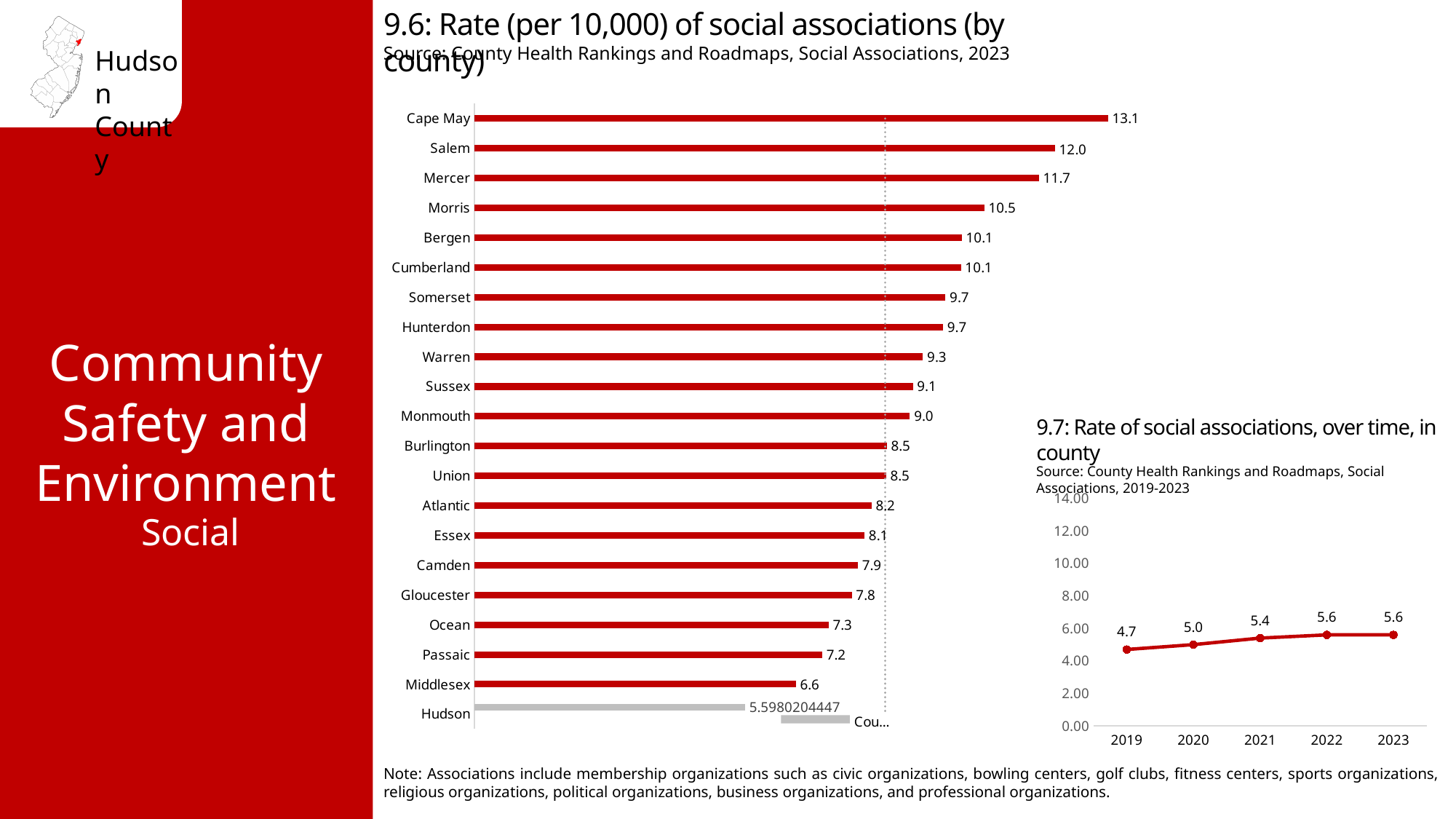
In the chart '9.7: Rate of social associations, over time, in county', what is the value for 2021? 5.4 In the chart '9.6: Rate (per 10,000) of social associations (by county)', which county has the highest rate? Cape May In the chart '9.7: Rate of social associations, over time, in county', do the values rise or fall from 2019 to 2023? Rise In the chart '9.7: Rate of social associations, over time, in county', what is the value for 2019? 4.7 In the chart '9.6: Rate (per 10,000) of social associations (by county)', how many counties are shown? 21 In the chart '9.6: Rate (per 10,000) of social associations (by county)', which has a higher rate, Ocean or Passaic? Ocean In the chart '9.6: Rate (per 10,000) of social associations (by county)', which county has the lowest rate? Hudson In the chart '9.6: Rate (per 10,000) of social associations (by county)', what is the value for Middlesex? 6.6 In the chart '9.6: Rate (per 10,000) of social associations (by county)', what is the difference between the values for Salem and Mercer? 0.3 What kind of chart is '9.6: Rate (per 10,000) of social associations (by county)'? Bar chart What kind of chart is '9.7: Rate of social associations, over time, in county'? Line chart In the chart '9.6: Rate (per 10,000) of social associations (by county)', what is the value for Cape May? 13.1